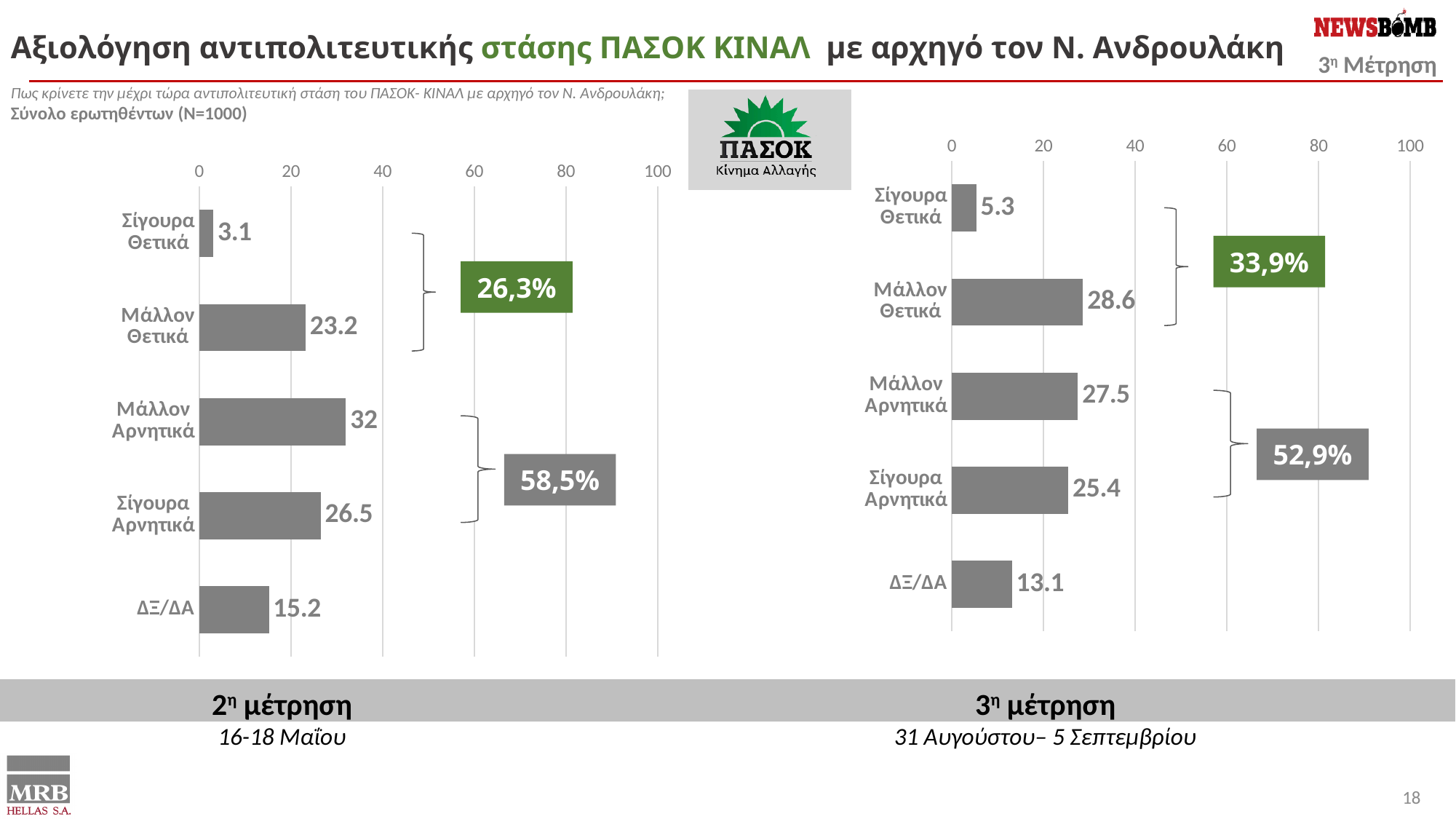
In the right chart (3η μέτρηση), which is larger: Σίγουρα Αρνητικά or Μάλλον Θετικά? Μάλλον Θετικά How many categories does the left chart (2η μέτρηση) show? 5 In the left chart (2η μέτρηση), what is the difference between Μάλλον Αρνητικά and Σίγουρα Αρνητικά? 5.5 In the left chart (2η μέτρηση), what is the value for Μάλλον Αρνητικά? 32 In the right chart (3η μέτρηση), which category has the lowest value? Σίγουρα Θετικά In the left chart (2η μέτρηση), which category has the highest value? Μάλλον Αρνητικά In the right chart (3η μέτρηση), what is the value for Μάλλον Θετικά? 28.6 In the left chart (2η μέτρηση), which category has the lowest value? Σίγουρα Θετικά In the right chart (3η μέτρηση), what is the value for ΔΞ/ΔΑ? 13.1 What kind of chart is the right chart (3η μέτρηση)? Bar chart In the left chart (2η μέτρηση), what combined percentage is shown in the grey box for the negative responses? 58,5% In the right chart (3η μέτρηση), what combined percentage is shown in the green box for the positive responses? 33,9%